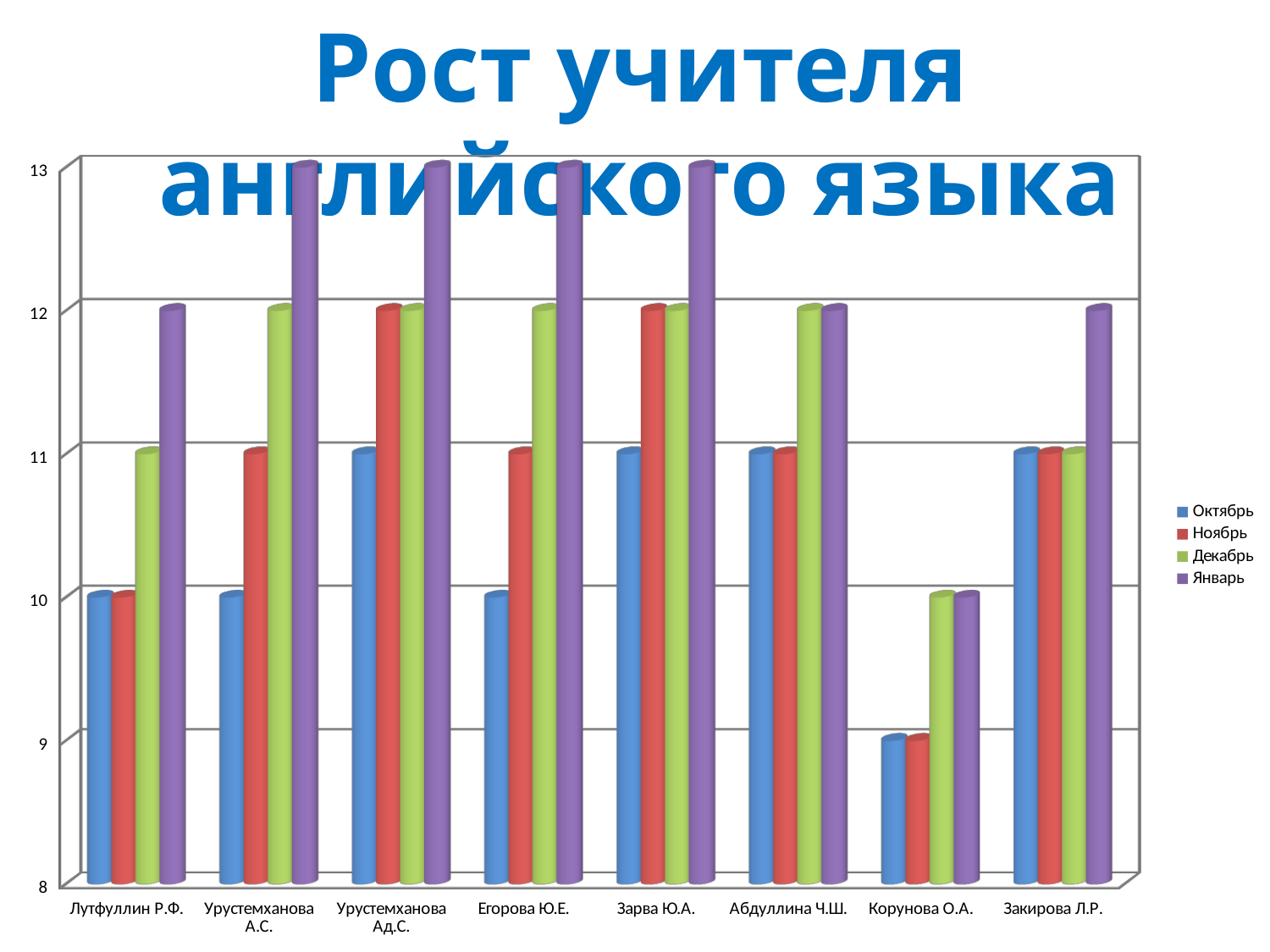
Do the values for Егорова Ю.Е. rise or fall from Октябрь to Январь? rise What is the value for Лутфуллин Р.Ф. in Январь? 12 Which series is shown in purple in the legend? Январь Which teacher has the lowest value in Декабрь? Корунова О.А. Is the Январь value for Корунова О.А. greater or less than 11? less What is the difference between the Январь and Октябрь values for Урустемханова А.С.? 3 What is the value for Корунова О.А. in Октябрь? 9 Which is larger: the Январь value for Закирова Л.Р. or the Январь value for Егорова Ю.Е.? Егорова Ю.Е. How many teachers (categories) are shown on the x axis? 8 What is the value for Урустемханова Ад.С. in Ноябрь? 12 What kind of chart is shown on the slide? bar chart How many series does the legend list? 4